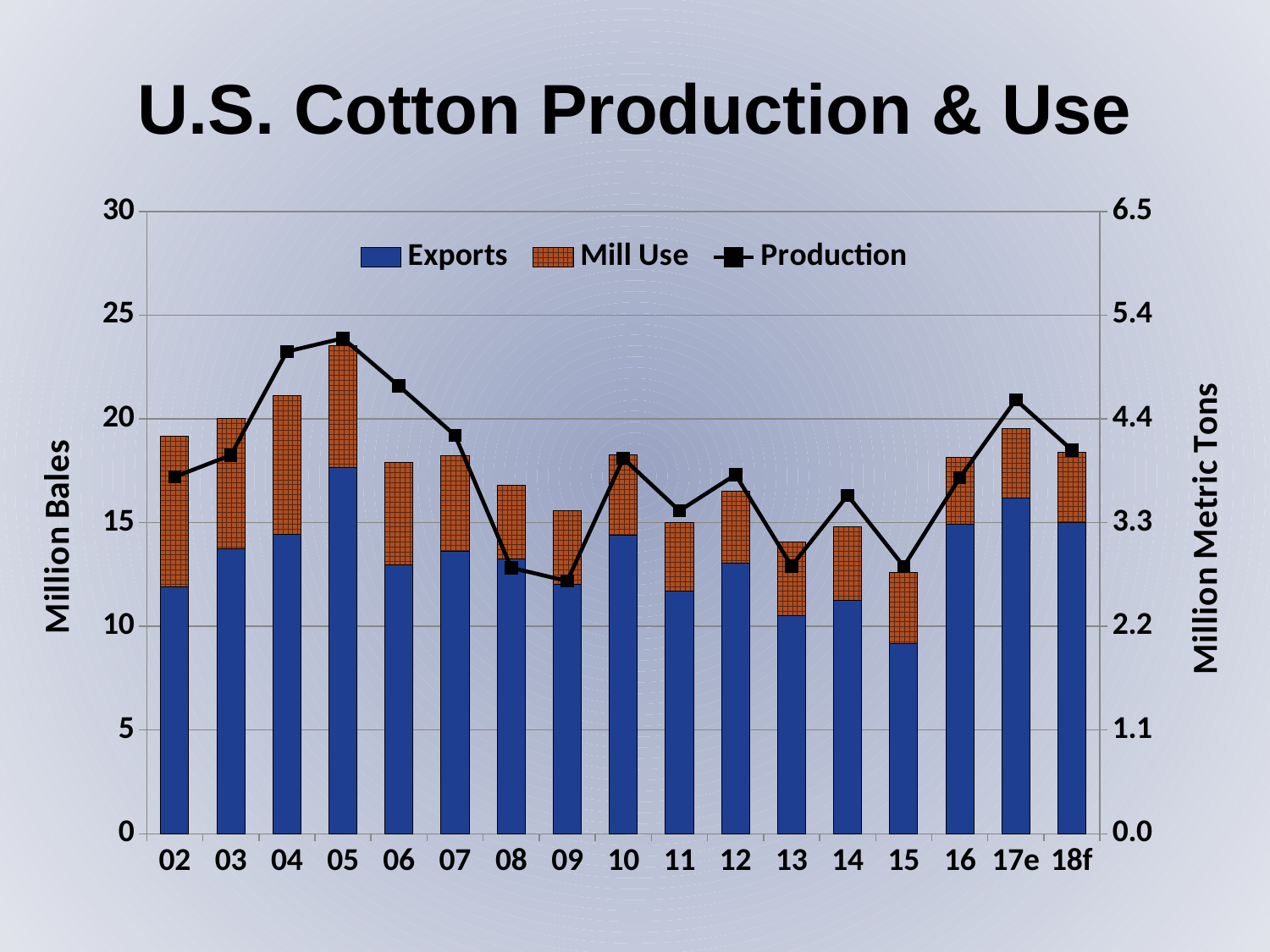
What kind of chart is shown on the slide? A bar chart with a line series Is the Exports value for 05 greater or less than 15 million bales? greater Which year has the larger Exports value, 16 or 17e? 17e In which year is the Exports bar the shortest? 15 In which year is the Exports bar the tallest? 05 What is the label on the right-hand vertical axis? Million Metric Tons How many years are shown along the x axis? 17 How many series does the legend list? 3 Does the Production line rise or fall from 05 to 09? Fall Is the Exports value for 15 greater or less than 10 million bales? less In which year does the Production line reach its highest point? 05 In which year is the combined Exports plus Mill Use bar the tallest? 05